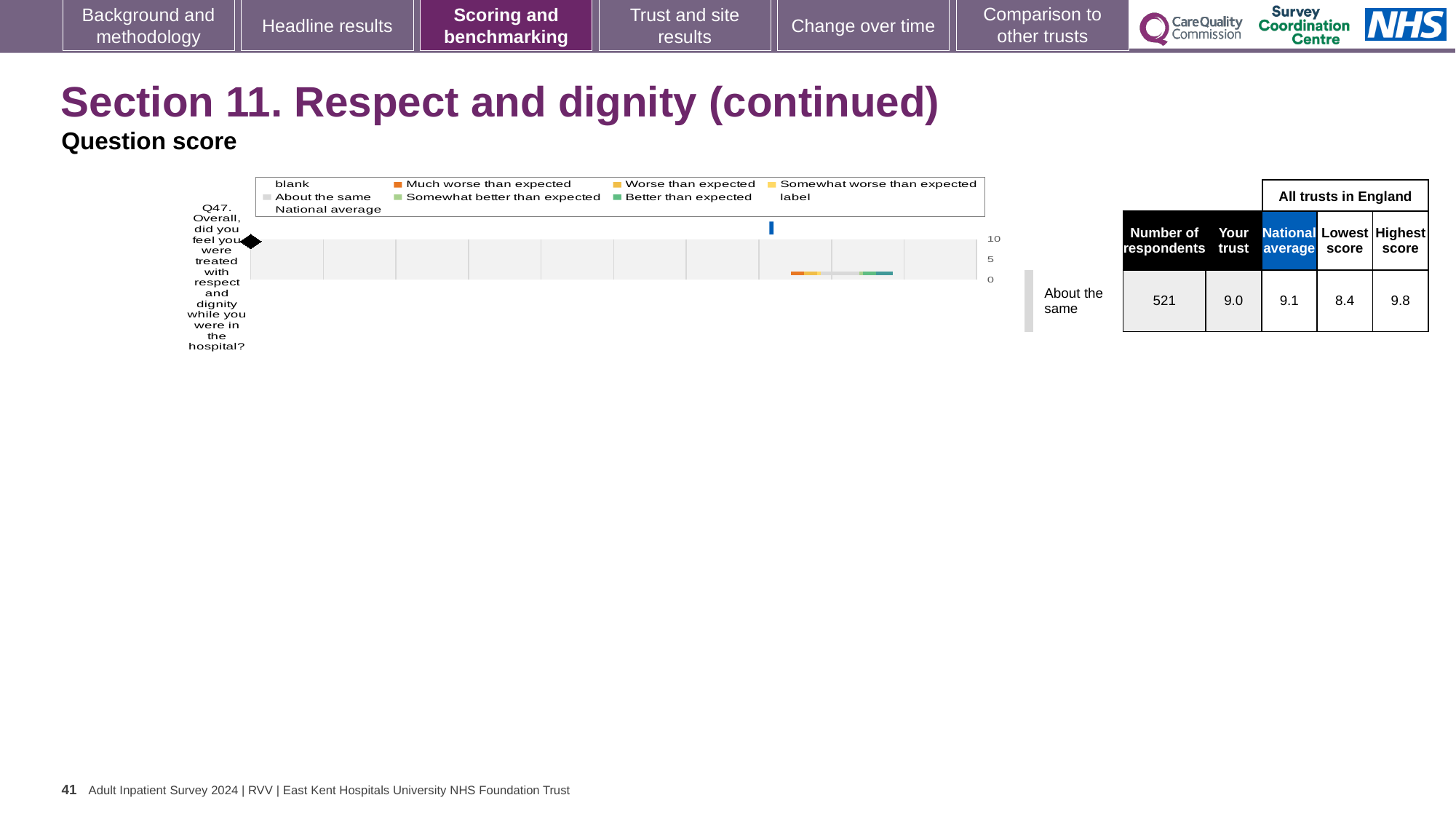
What is the lowest score among all trusts in England for Q47? 8.4 What kind of chart is used to show the Q47 question score? bar chart Which question is plotted on the question score chart? Q47. Overall, did you feel you were treated with respect and dignity while you were in the hospital? What is the difference between the highest and lowest scores for Q47 across all trusts in England? 1.4 What is the national average score for Q47? 9.1 How many questions are plotted on the question score chart? 1 For Q47, which is larger: the trust's score or the national average? national average What is the highest score among all trusts in England for Q47? 9.8 Is the trust's score for Q47 greater or less than 5 on the chart axis? greater What is the 'Your trust' score for Q47? 9.0 Which legend entry is shown in orange on the question score chart? Much worse than expected How many respondents answered Q47? 521